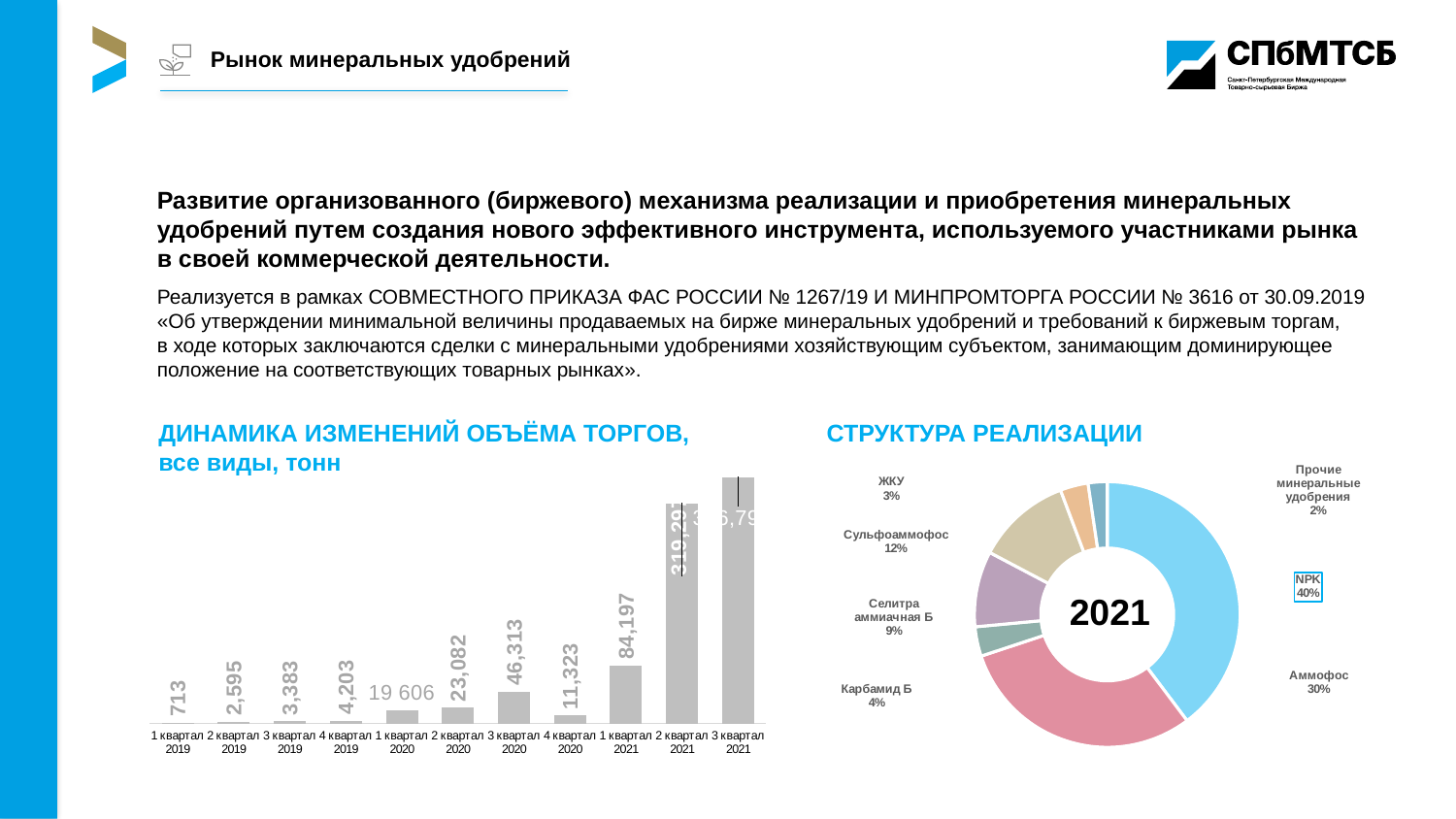
In the bar chart 'ДИНАМИКА ИЗМЕНЕНИЙ ОБЪЁМА ТОРГОВ', which quarter has the highest value? 3 квартал 2021 In the bar chart 'ДИНАМИКА ИЗМЕНЕНИЙ ОБЪЁМА ТОРГОВ', which is larger: the value for 3 квартал 2020 or 4 квартал 2020? 3 квартал 2020 In the chart 'СТРУКТУРА РЕАЛИЗАЦИИ', which category has the smallest share? Прочие минеральные удобрения In the bar chart 'ДИНАМИКА ИЗМЕНЕНИЙ ОБЪЁМА ТОРГОВ', what is the difference between the values for 2 квартал 2020 and 1 квартал 2020? 3,476 In the bar chart 'ДИНАМИКА ИЗМЕНЕНИЙ ОБЪЁМА ТОРГОВ, все виды, тонн', what is the value for 1 квартал 2019? 713 In the bar chart 'ДИНАМИКА ИЗМЕНЕНИЙ ОБЪЁМА ТОРГОВ', which quarter has the lowest value? 1 квартал 2019 How many quarters (bars) are shown in the bar chart 'ДИНАМИКА ИЗМЕНЕНИЙ ОБЪЁМА ТОРГОВ'? 11 In the chart 'СТРУКТУРА РЕАЛИЗАЦИИ', what share does NPK have? 40% How many categories are shown in the chart 'СТРУКТУРА РЕАЛИЗАЦИИ'? 7 In the bar chart 'ДИНАМИКА ИЗМЕНЕНИЙ ОБЪЁМА ТОРГОВ', what is the value for 3 квартал 2020? 46,313 In the chart 'СТРУКТУРА РЕАЛИЗАЦИИ', what share does Аммофос have? 30% In the bar chart 'ДИНАМИКА ИЗМЕНЕНИЙ ОБЪЁМА ТОРГОВ', what is the value for 1 квартал 2021? 84,197